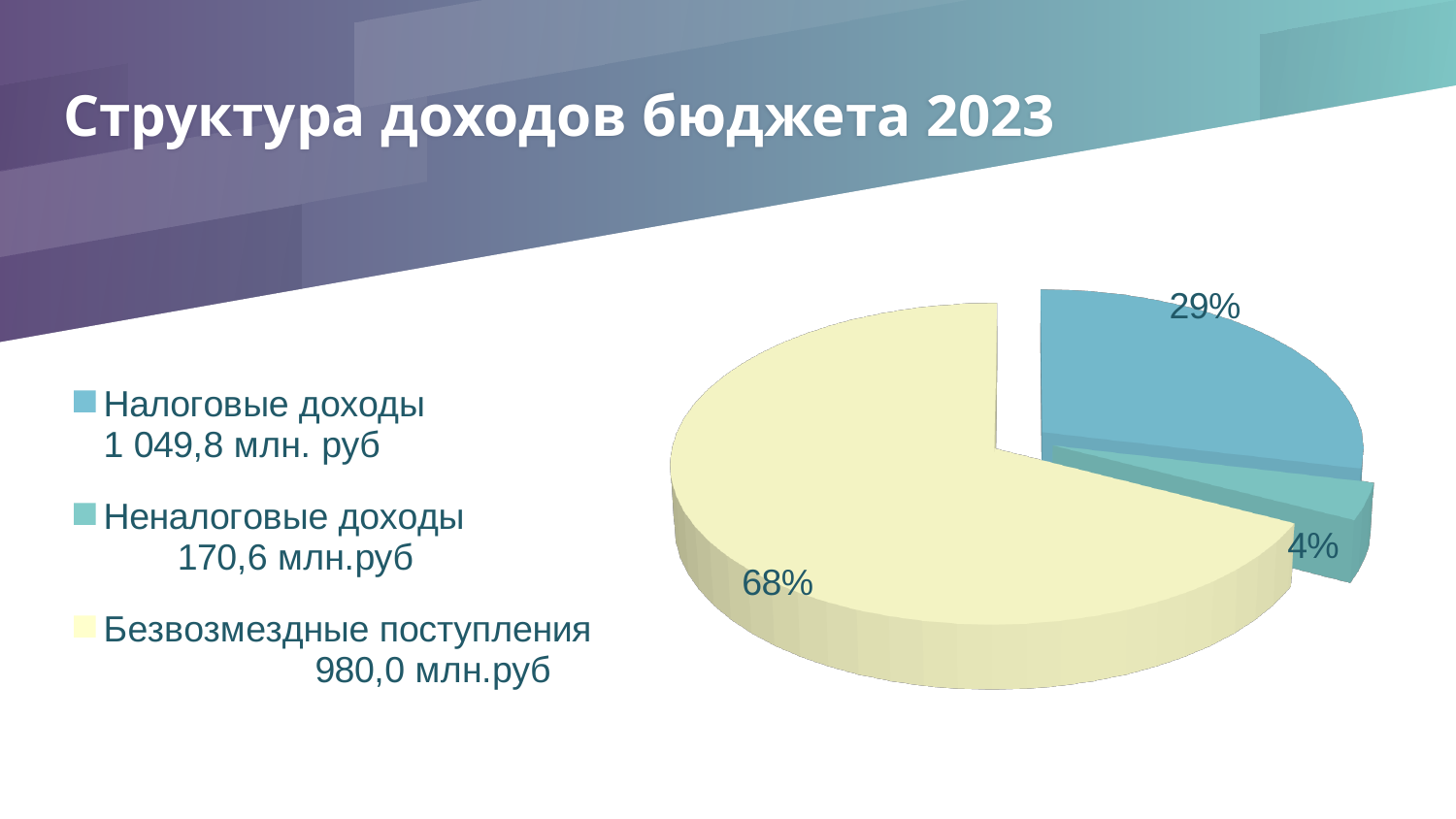
What percentage share is shown for the Налоговые доходы slice? 29% What value does the legend give for Безвозмездные поступления? 980,0 млн.руб What percentage share is shown for the Безвозмездные поступления slice? 68% How many slices does the pie chart have? 3 Which slice has the smallest share of the pie? Неналоговые доходы What is the chart's title? Структура доходов бюджета 2023 What kind of chart is shown on the slide? Pie chart How many entries does the legend list? 3 What value does the legend give for Неналоговые доходы? 170,6 млн.руб What percentage share is shown for the Неналоговые доходы slice? 4% Which slice has the largest share of the pie? Безвозмездные поступления What colour is the Безвозмездные поступления slice? Yellow